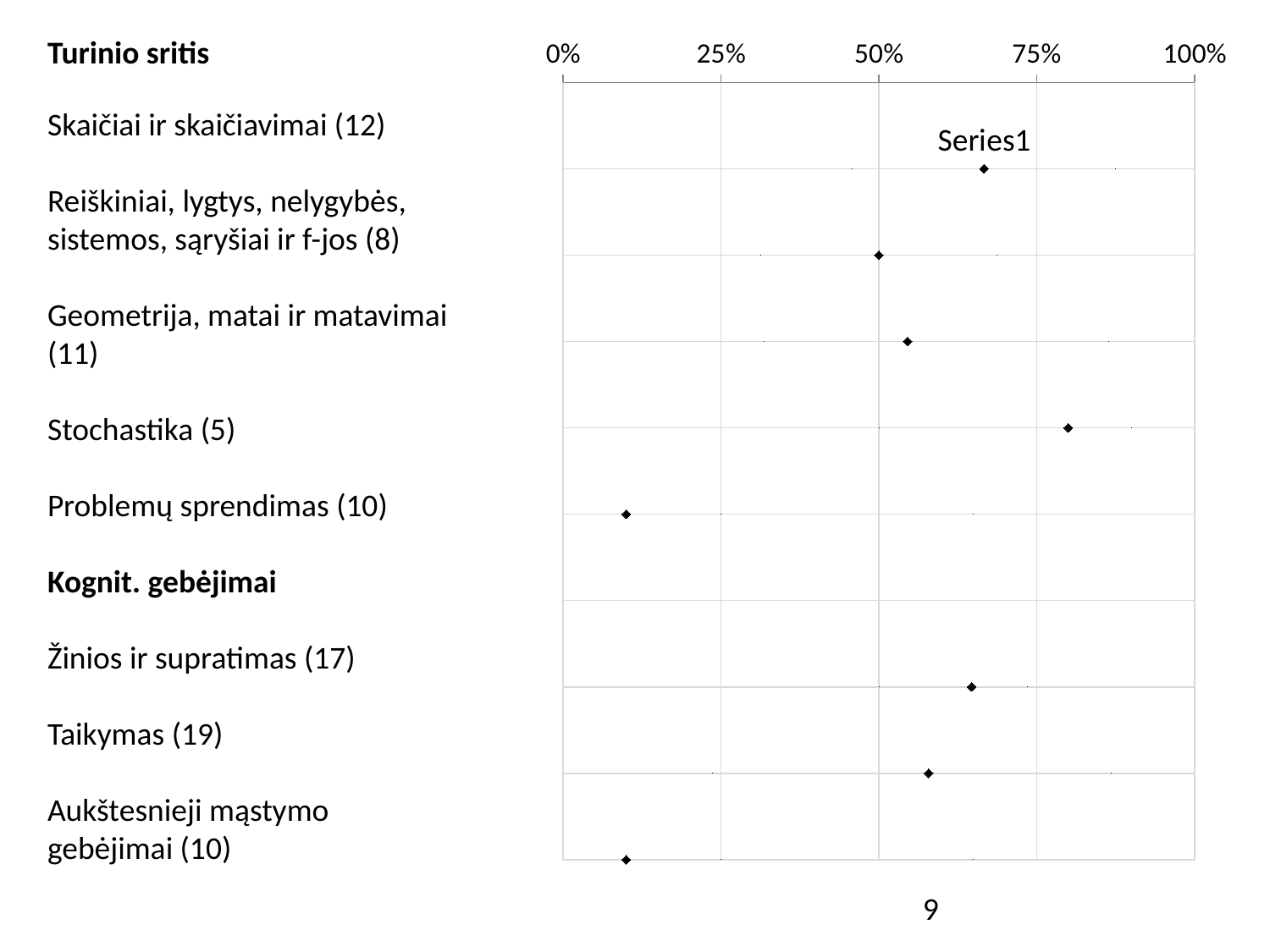
Which is larger, the value for Stochastika (5) or the value for Skaičiai ir skaičiavimai (12)? Stochastika (5) Which is larger, the value for Skaičiai ir skaičiavimai (12) or the value for Reiškiniai, lygtys, nelygybės, sistemos, sąryšiai ir f-jos (8)? Skaičiai ir skaičiavimai (12) Is the value for Problemų sprendimas (10) greater or less than 25%? less Is the value for Skaičiai ir skaičiavimai (12) greater or less than 50%? greater What is the name of the series shown in the chart legend? Series1 Is the value for Stochastika (5) greater or less than 75%? greater What kind of chart is shown on the slide? scatter chart How many data points are plotted in the chart? 8 Which category has the highest value in the chart? Stochastika (5) How many series does the chart legend list? 1